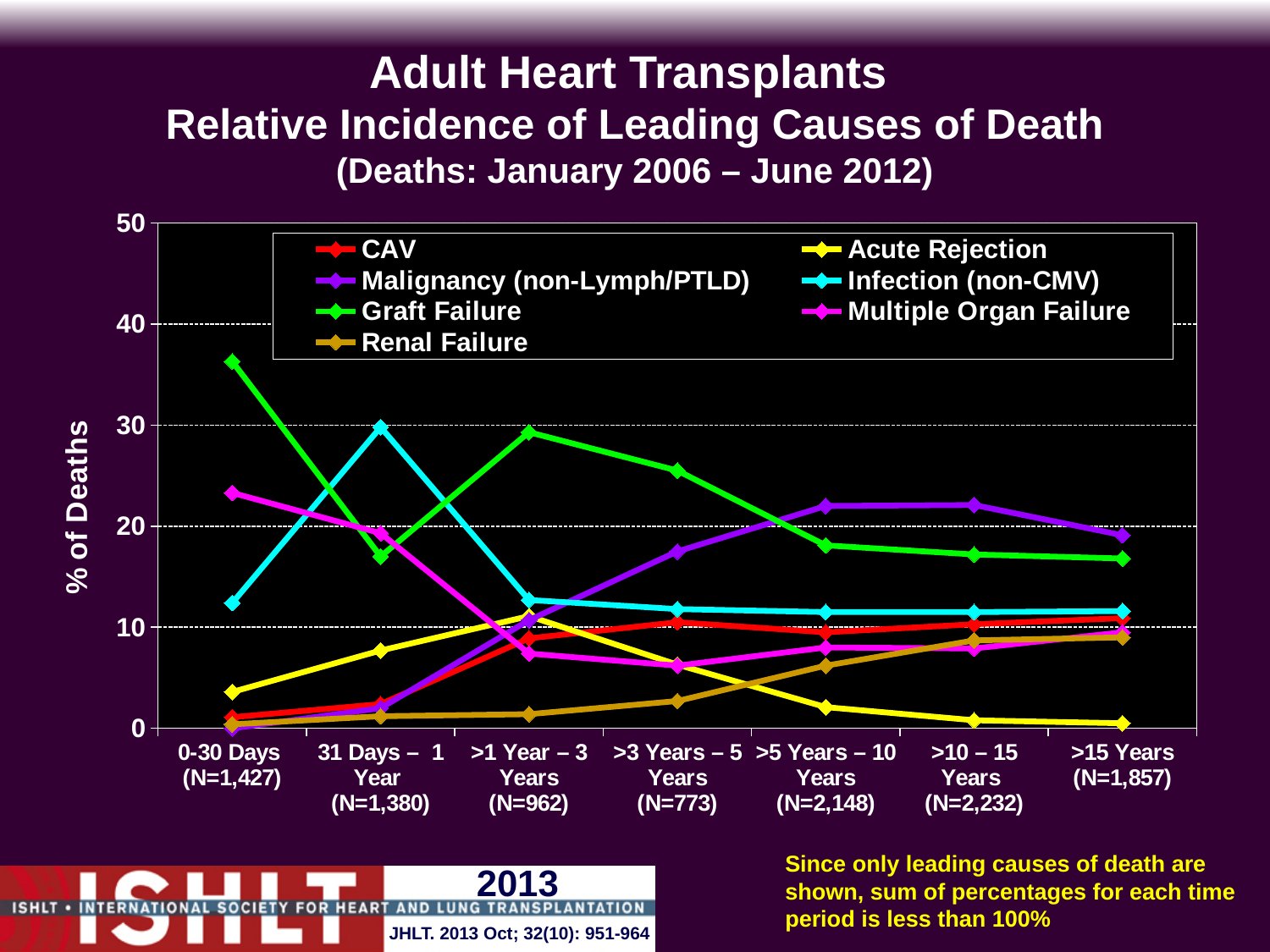
In the >3 Years – 5 Years period, which is larger: Graft Failure or Malignancy (non-Lymph/PTLD)? Graft Failure Is the value for Graft Failure in the 0-30 Days period greater or less than 30? greater What is the label on the y axis? % of Deaths Is the value for Infection (non-CMV) in the 31 Days – 1 Year period greater or less than 20? greater How many time periods are shown along the x axis? 7 Does the Renal Failure line rise or fall across the time periods from 0-30 Days to >15 Years? rise What kind of chart is shown on the slide? line chart Which cause of death has the highest % of deaths in the >5 Years – 10 Years period? Malignancy (non-Lymph/PTLD) How many series does the legend list? 7 Which cause of death has the highest % of deaths in the 31 Days – 1 Year period? Infection (non-CMV) Which cause of death has the highest % of deaths in the 0-30 Days period? Graft Failure Which cause of death has the lowest % of deaths in the >15 Years period? Acute Rejection